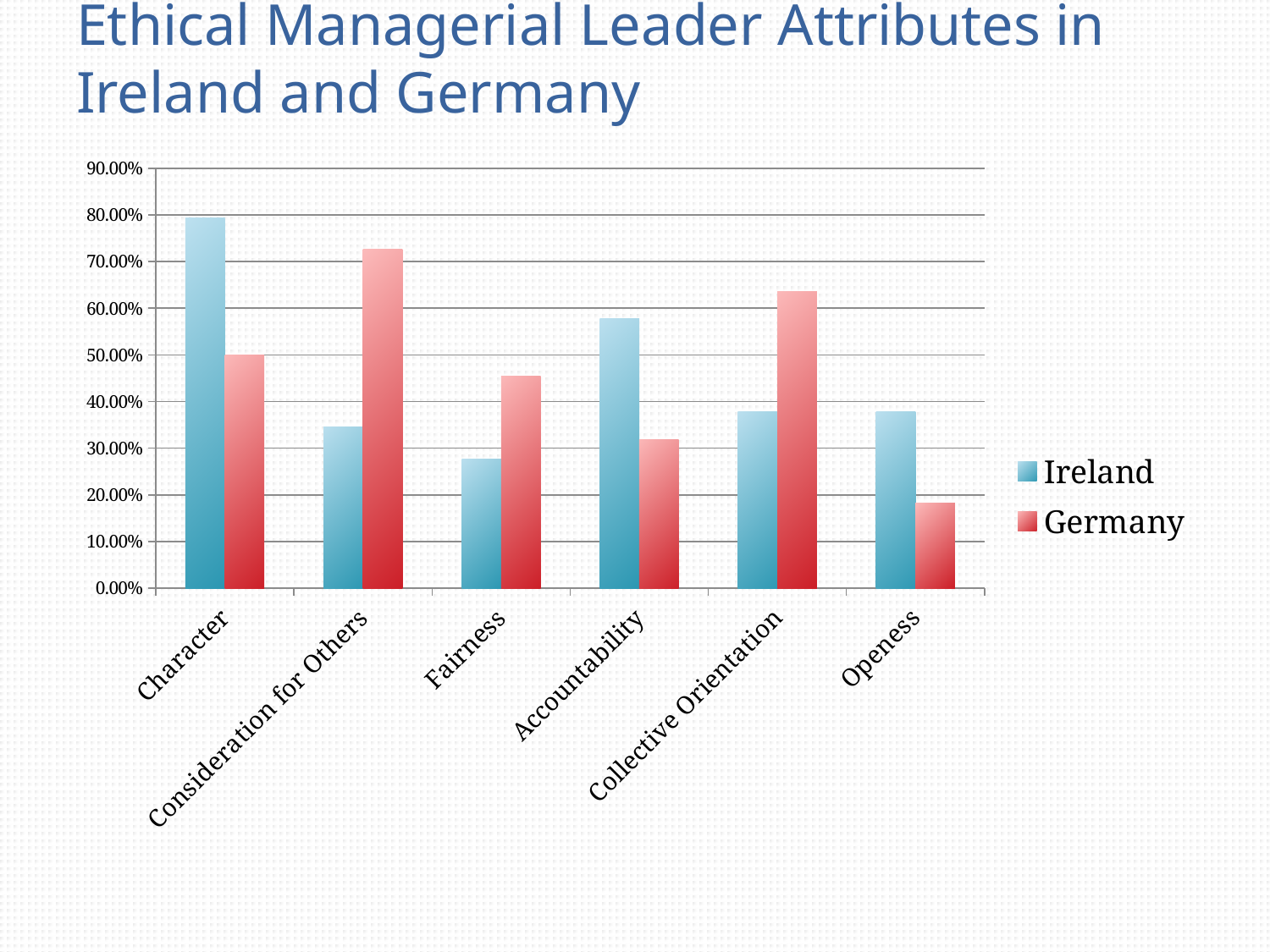
Is the value for Ireland on Accountability greater or less than 50.00%? greater Which attribute has the lowest value for Ireland? Fairness For Consideration for Others, which country has the larger value, Ireland or Germany? Germany What kind of chart is shown on the slide? bar chart For Character, which country has the larger value, Ireland or Germany? Ireland Which attribute has the lowest value for Germany? Openess Which attribute has the highest value for Ireland? Character Which attribute has the highest value for Germany? Consideration for Others Is the value for Germany on Collective Orientation greater or less than 60.00%? greater Which colour represents Germany in the legend? red How many attribute categories are shown on the x axis? 6 How many series does the legend list? 2